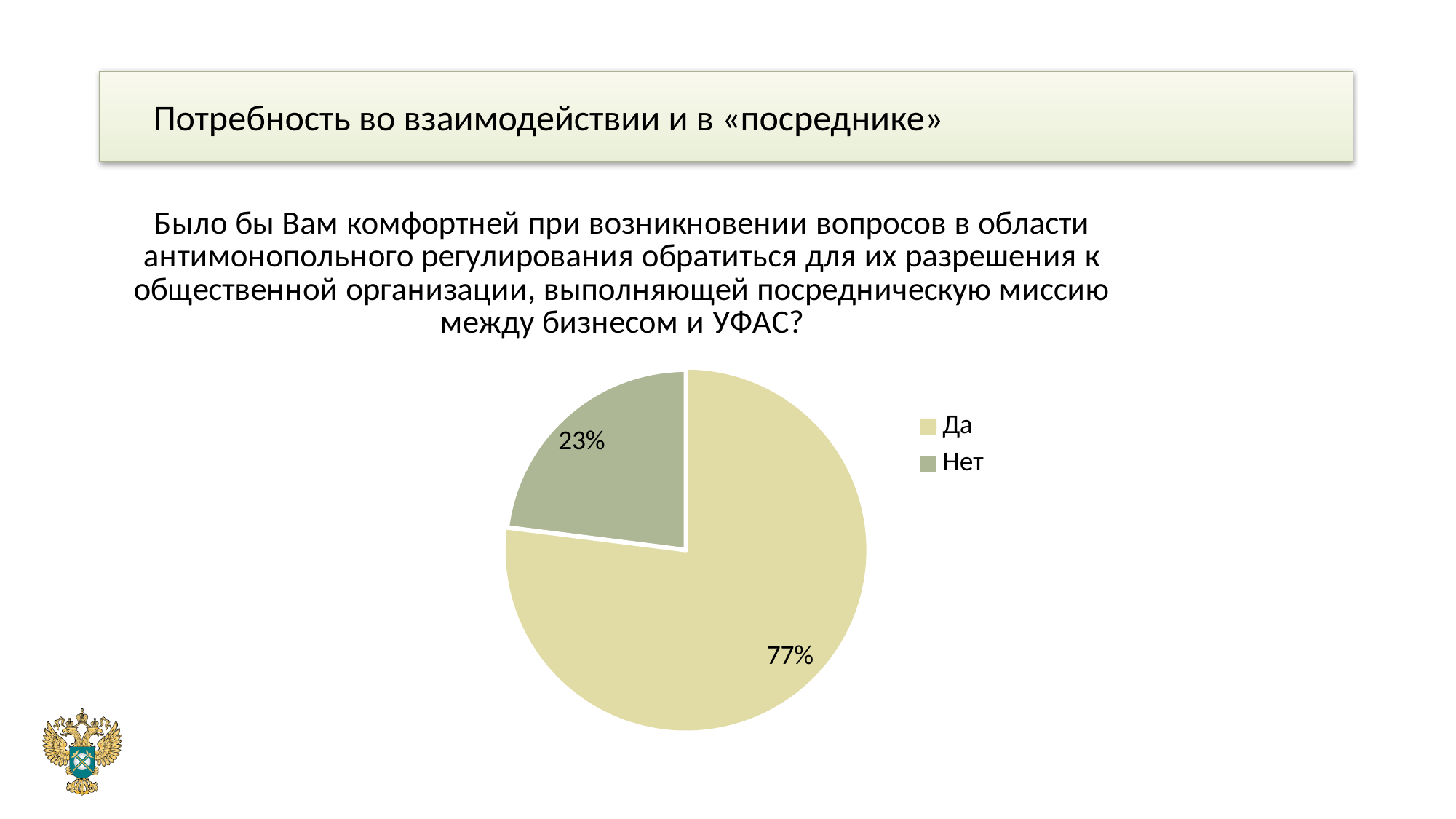
What share of the pie does the "Да" slice represent? 77% What type of chart is shown on the slide? pie chart Which is larger, the "Да" slice or the "Нет" slice? Да What is the difference in percentage points between the "Да" and "Нет" slices? 54 Which slice of the pie is the largest? Да Which legend entry is shown in the darker grey-green colour? Нет What share of the pie does the "Нет" slice represent? 23% Which slice of the pie is the smallest? Нет How many slices does the pie chart have? 2 How many entries does the legend list? 2 What are the two legend entries of the pie chart? Да, Нет